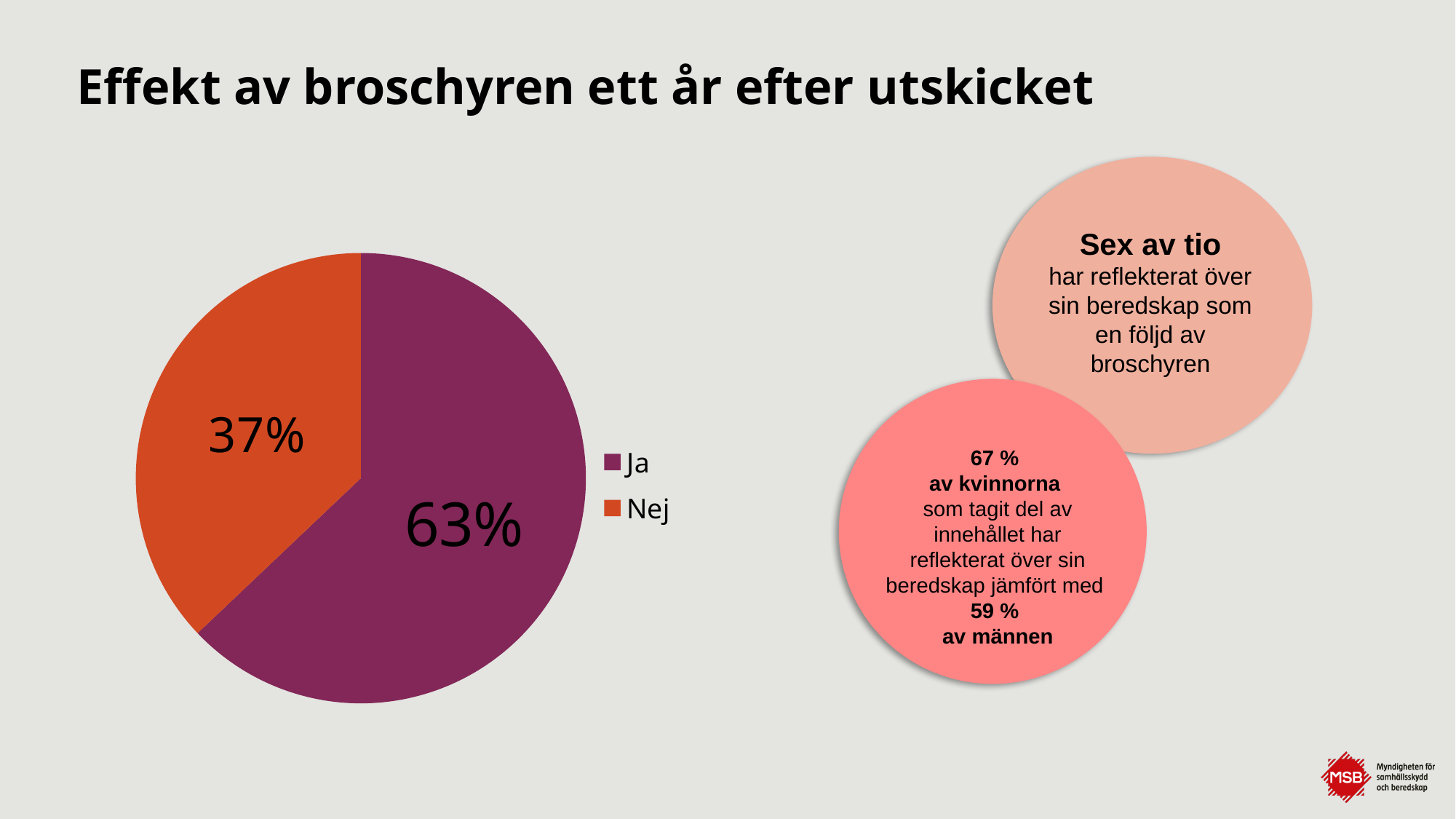
What colour is the "Ja" slice in the pie chart? purple What share of the pie does "Ja" represent? 63% Which slice of the pie is the smallest? Nej Is the value for "Nej" greater or less than 50%? less What kind of chart is shown on the slide? pie chart How many slices does the pie chart have? 2 How many entries does the legend list? 2 Which slice of the pie is the largest? Ja What is the title of the slide containing the pie chart? Effekt av broschyren ett år efter utskicket What is the difference in percentage points between the "Ja" and "Nej" slices? 26 Which is larger, the "Ja" slice or the "Nej" slice? Ja What share of the pie does "Nej" represent? 37%